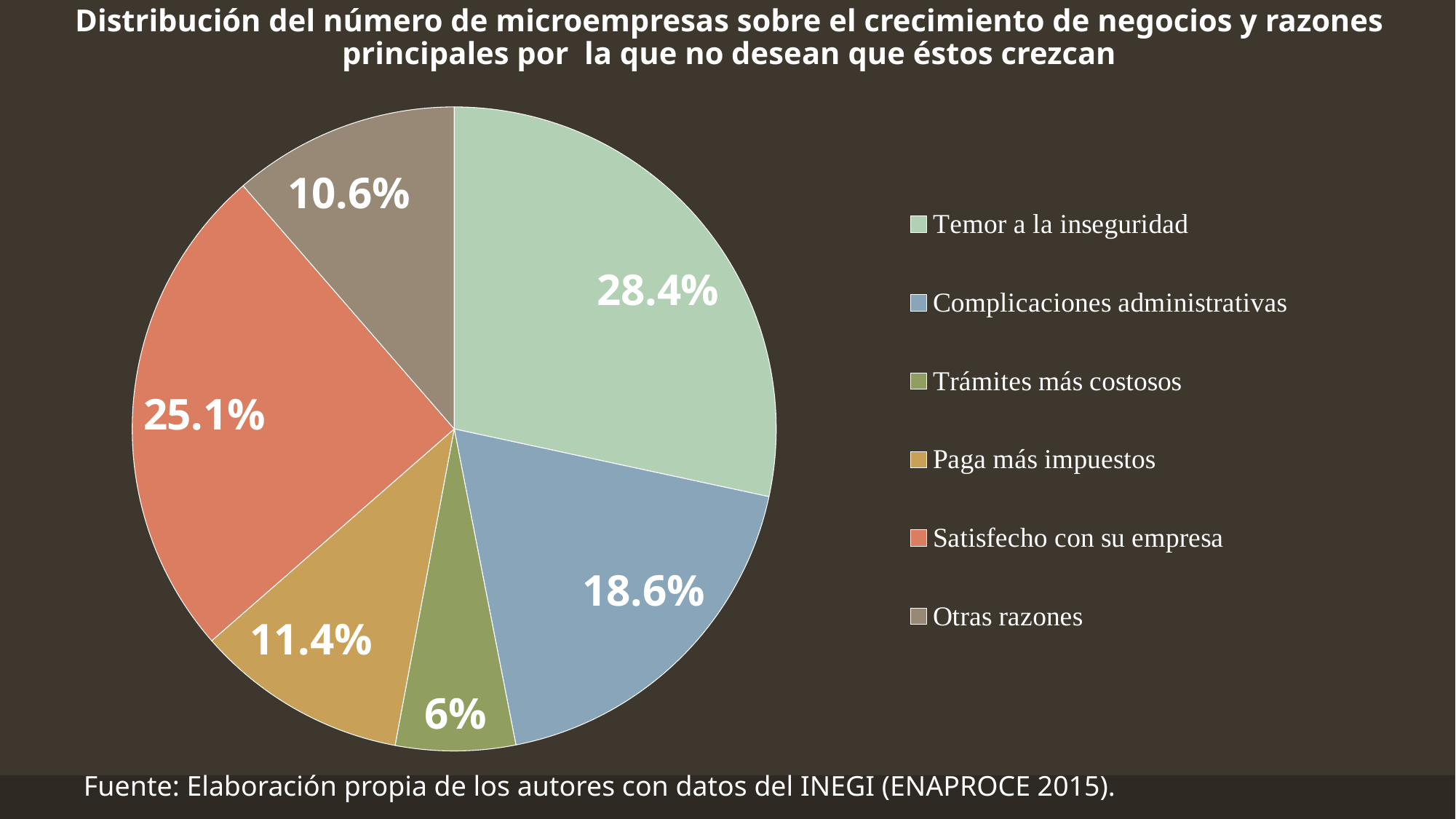
What kind of chart is shown on the slide? pie chart How many categories does the pie chart have? 6 What is the difference in percentage points between "Temor a la inseguridad" and "Satisfecho con su empresa"? 3.3 What is the value shown for "Trámites más costosos"? 6% Which category has the smallest slice of the pie? Trámites más costosos What is the value shown for "Satisfecho con su empresa"? 25.1% What share of the pie does "Temor a la inseguridad" represent? 28.4% Which is larger, the slice for "Paga más impuestos" or the slice for "Otras razones"? Paga más impuestos Which category has the largest slice of the pie? Temor a la inseguridad What is the value shown for "Complicaciones administrativas"? 18.6% What colour is the slice for "Satisfecho con su empresa"? red What is the value shown for "Otras razones"? 10.6%